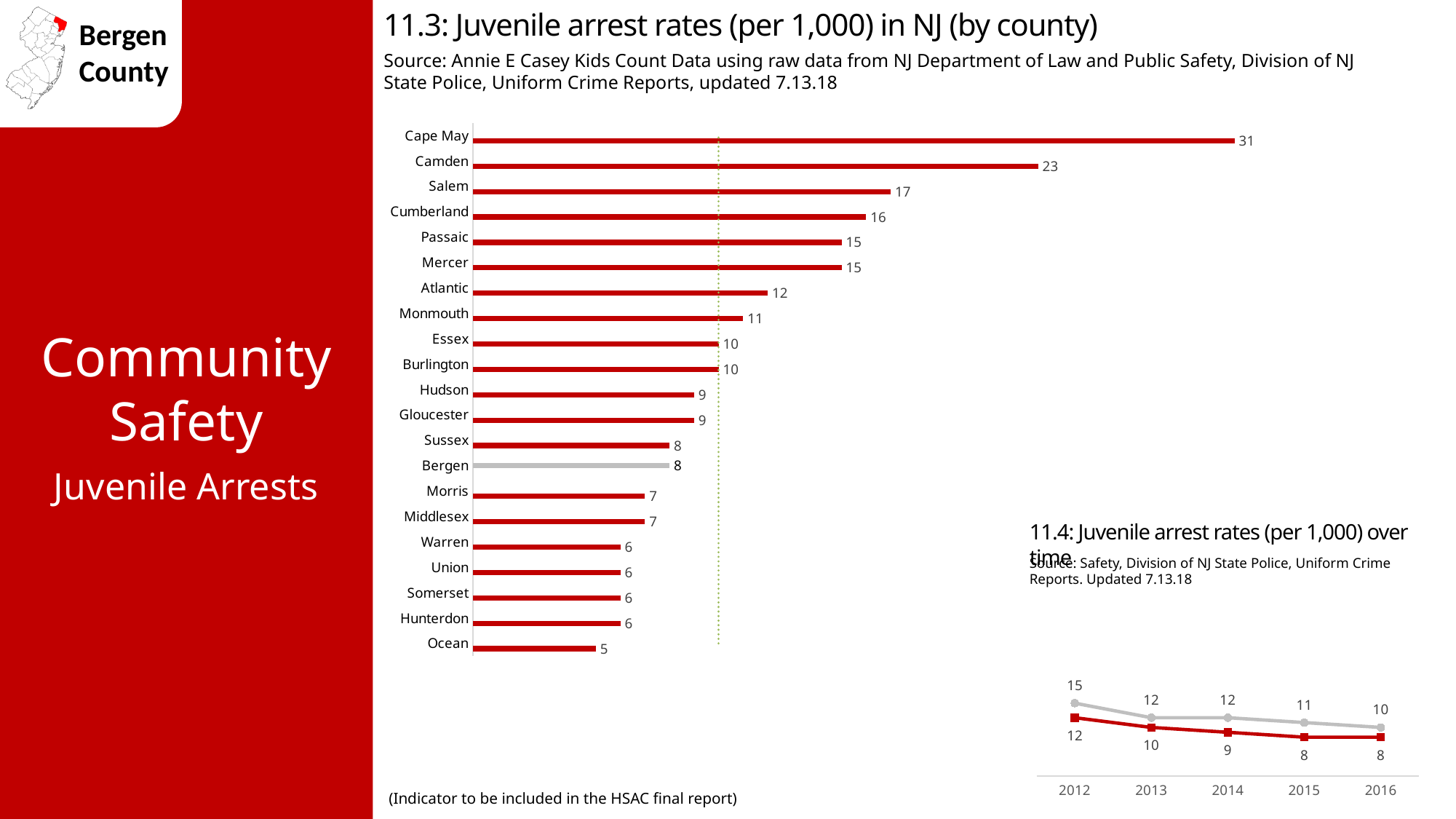
In chart 11.3 (juvenile arrest rates by county), what is the value for Bergen? 8 In chart 11.3 (juvenile arrest rates by county), which county's bar is coloured gray instead of red? Bergen In chart 11.3 (juvenile arrest rates by county), which county has the lowest juvenile arrest rate? Ocean In chart 11.3 (juvenile arrest rates by county), which county has the highest juvenile arrest rate? Cape May In chart 11.3 (juvenile arrest rates by county), which is larger, the value for Atlantic or the value for Monmouth? Atlantic What kind of chart is chart 11.3 (juvenile arrest rates by county)? Bar chart In chart 11.4 (juvenile arrest rates over time), what is the value of the red line in 2014? 9 In chart 11.3 (juvenile arrest rates by county), what is the value for Cape May? 31 In chart 11.4 (juvenile arrest rates over time), what is the value of the gray line in 2012? 15 In chart 11.3 (juvenile arrest rates by county), what is the difference between the values for Camden and Salem? 6 In chart 11.3 (juvenile arrest rates by county), how many counties are shown? 21 In chart 11.4 (juvenile arrest rates over time), do the values of the red line rise or fall from 2012 to 2016? Fall